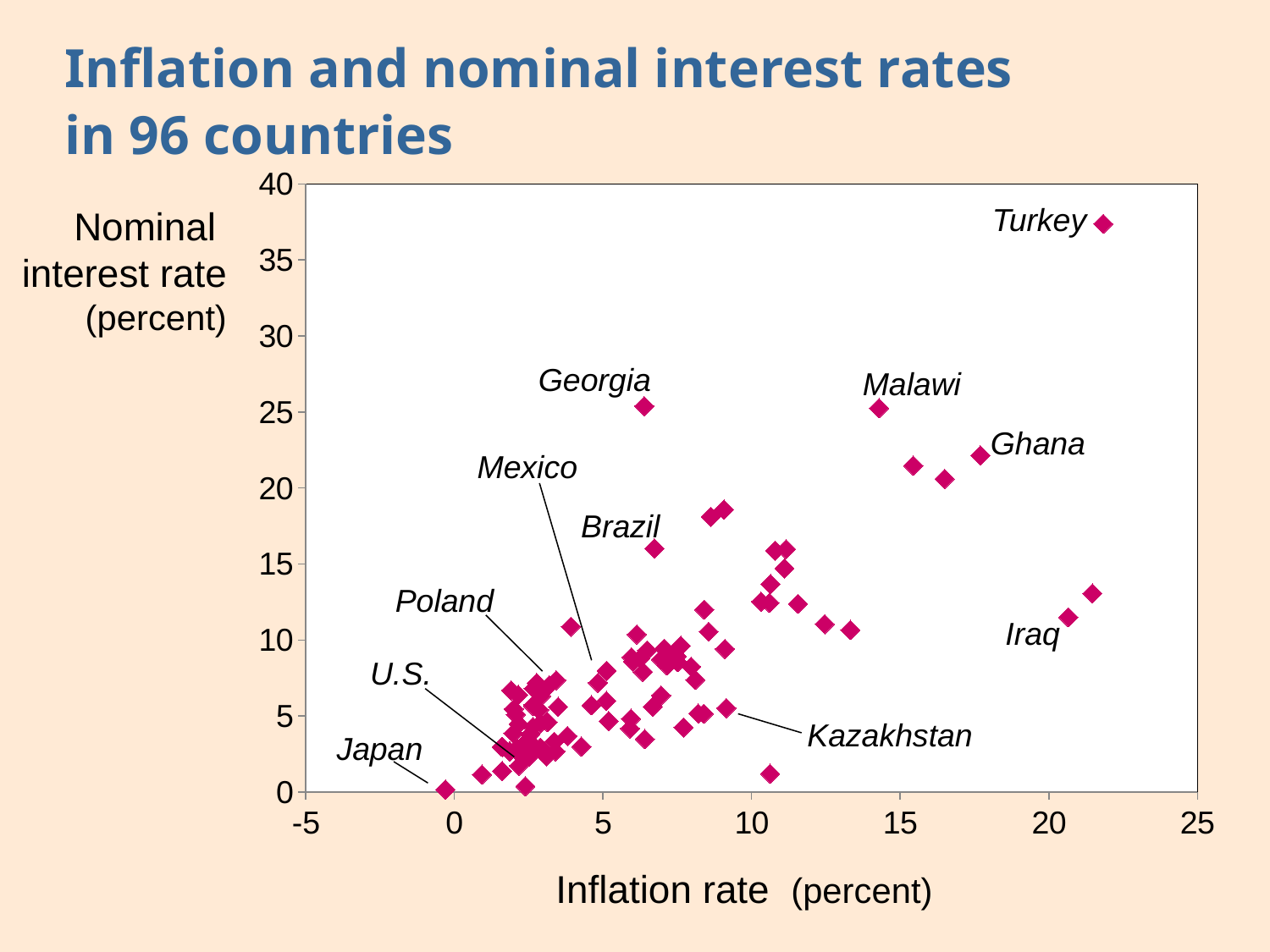
Is the inflation rate for Ghana greater or less than 15? greater Which has the higher inflation rate, Iraq or Poland? Iraq Is the inflation rate for Japan greater or less than 5? less As the inflation rate increases along the x axis, do nominal interest rates generally rise or fall? rise Is the nominal interest rate for Turkey greater or less than 35? greater Which has the higher nominal interest rate, Malawi or Brazil? Malawi What kind of chart is shown on the slide? scatter plot Which labeled country has the lowest nominal interest rate? Japan What is the label of the horizontal axis? Inflation rate (percent) Which labeled country has the highest nominal interest rate? Turkey